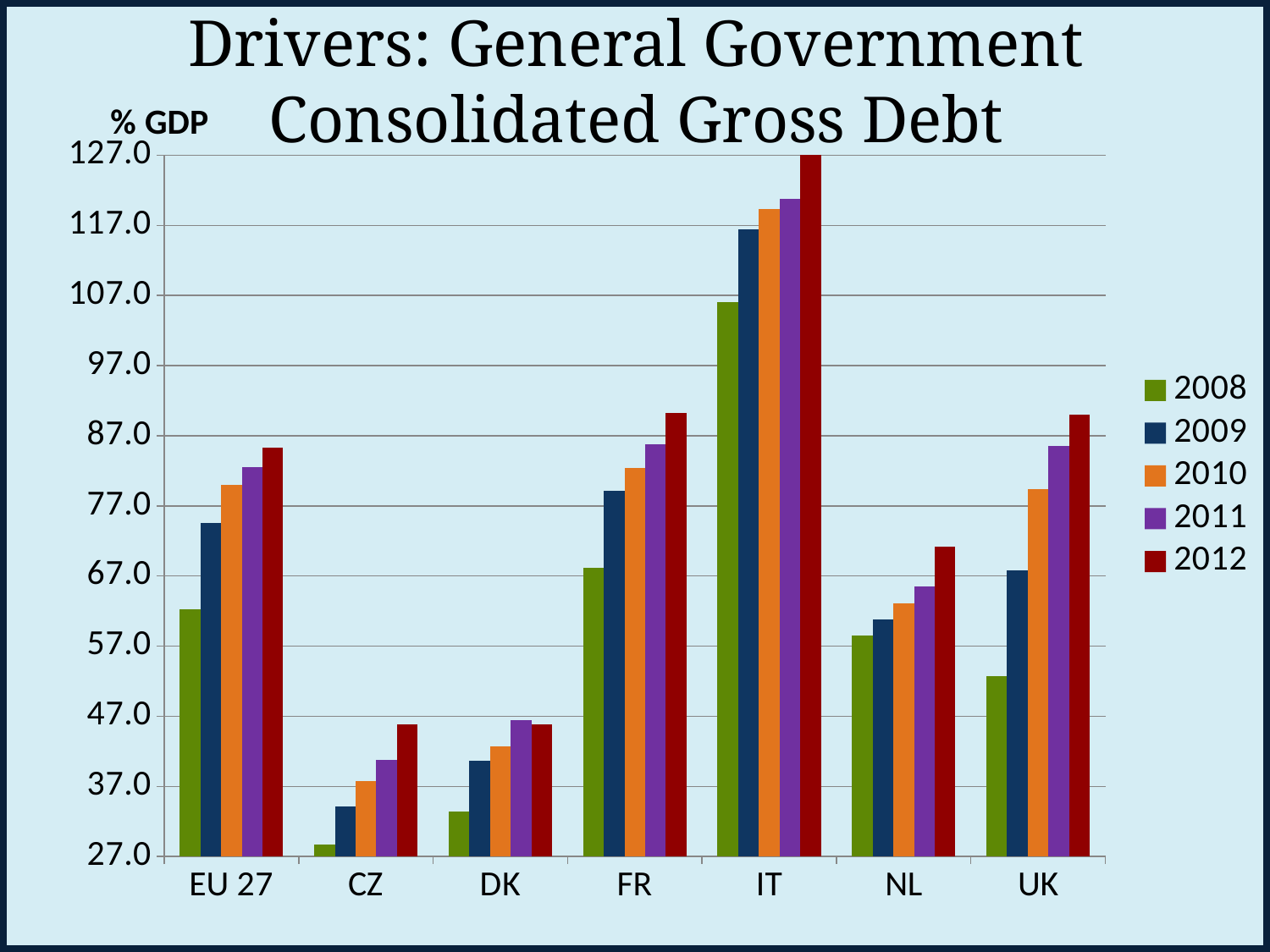
What unit is shown on the y axis label? % GDP Which category has the lowest 2008 value? CZ Is the 2012 value for NL greater or less than 67.0? greater Which is larger, the 2012 value for NL or the 2012 value for UK? UK Do the EU 27 values rise or fall from 2008 to 2012? rise Is the 2008 value for UK greater or less than 57.0? less How many countries/regions are shown on the x axis? 7 How many series does the legend list? 5 Which country has the highest gross debt as % of GDP in 2012? IT Is the 2008 value for DK greater or less than 37.0? less What kind of chart is shown on the slide? bar chart